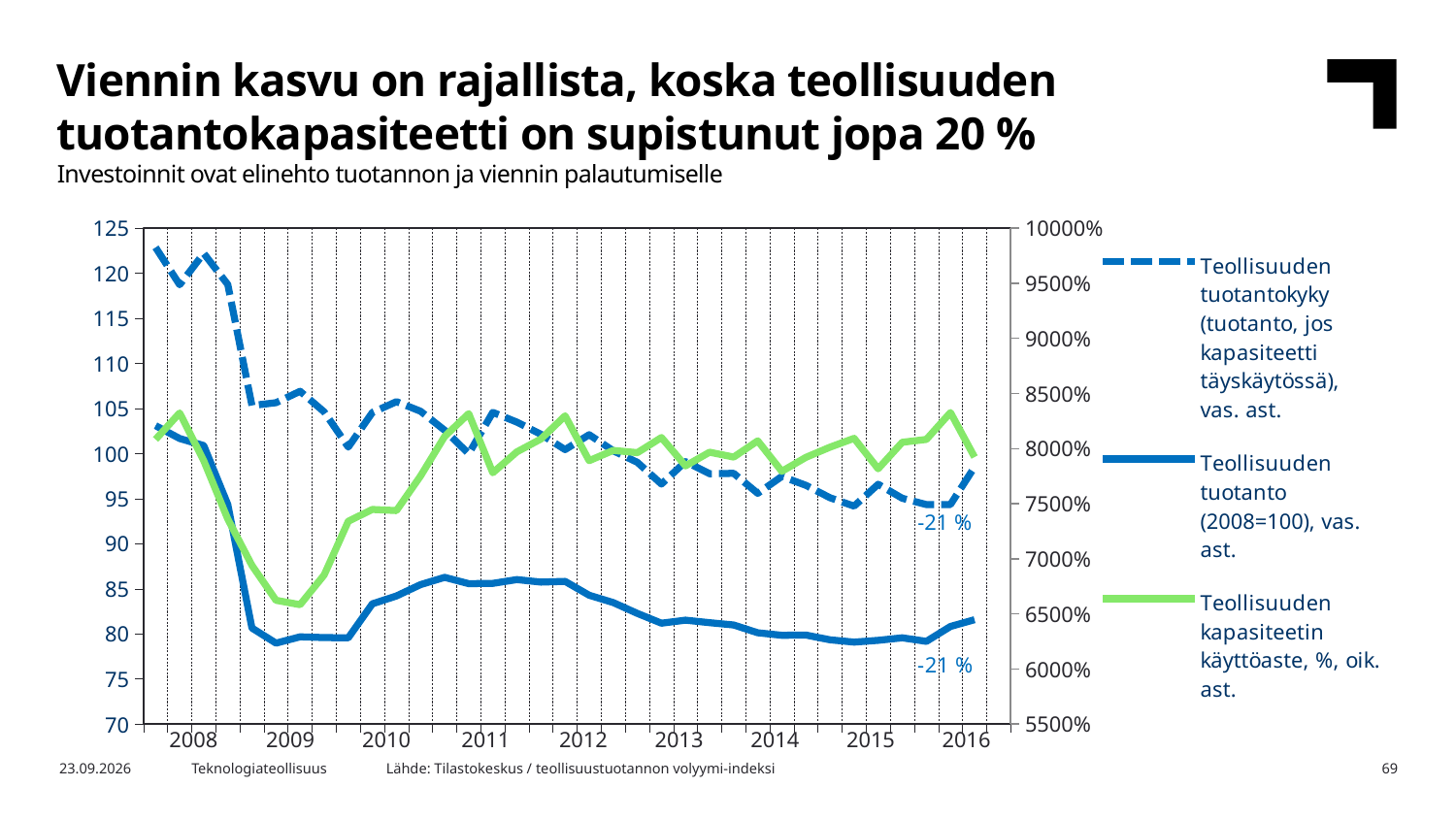
What kind of chart is shown on the slide? line chart How many years are labelled on the x axis? 9 Which series is drawn with a dashed line? Teollisuuden tuotantokyky (tuotanto, jos kapasiteetti täyskäytössä), vas. ast. Which series is plotted against the right-hand axis (oik. ast.)? Teollisuuden kapasiteetin käyttöaste, %, oik. ast. How many series does the legend list? 3 Is the value of Teollisuuden tuotanto (2008=100) at the start of 2009 greater or less than 85? less Does the Teollisuuden tuotanto (2008=100) series rise or fall from 2008 to 2016? fall What percentage change label is printed next to the blue lines near 2016? -21 % At the end of 2016, which is higher on the left axis: Teollisuuden tuotantokyky or Teollisuuden tuotanto (2008=100)? Teollisuuden tuotantokyky Is the value of Teollisuuden tuotanto (2008=100) at the end of 2016 greater or less than 85? less Is the value of Teollisuuden tuotantokyky at the start of 2008 greater or less than 120? greater Does the Teollisuuden tuotantokyky series rise or fall from 2008 to 2016? fall